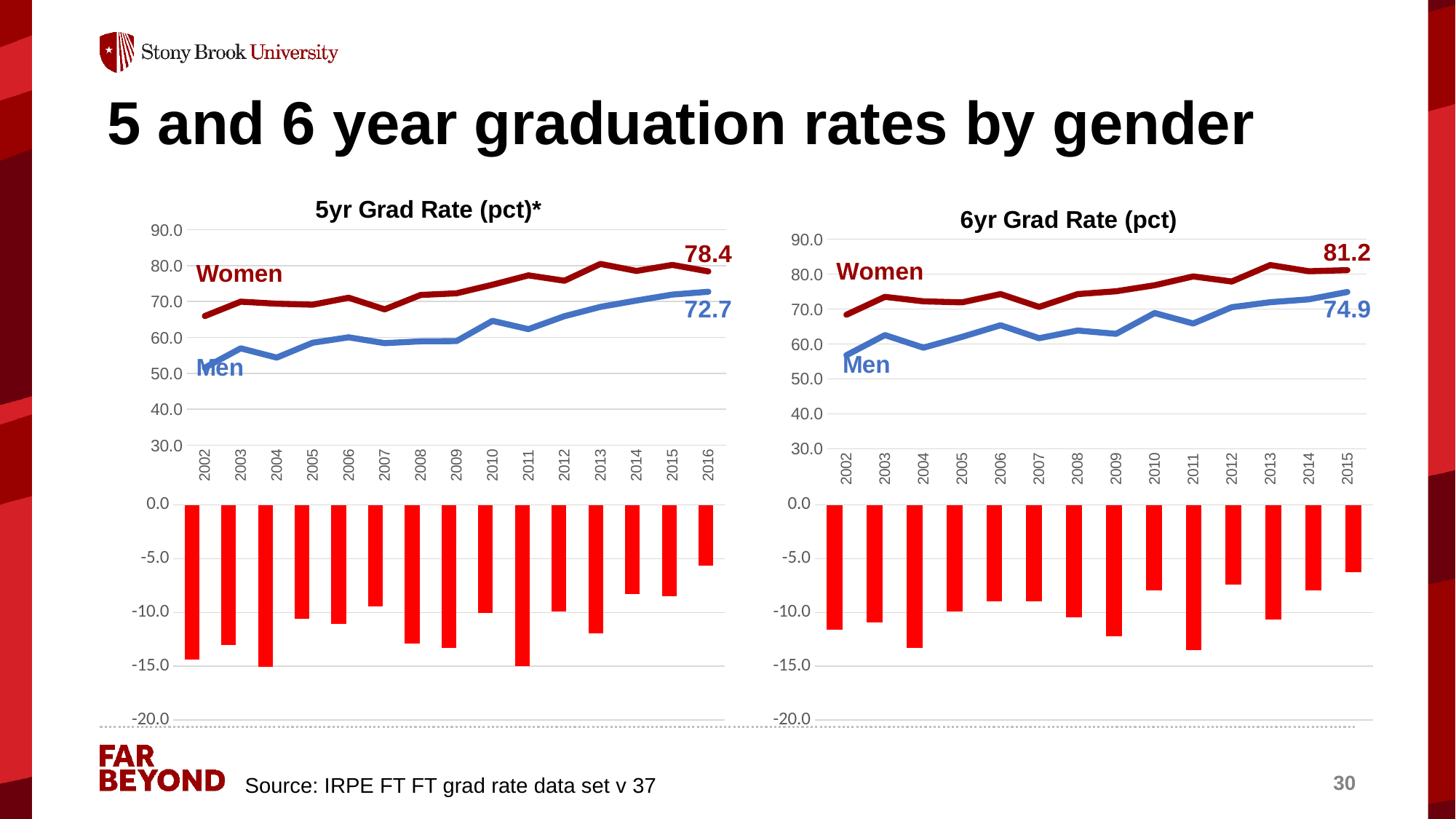
On the 6yr Grad Rate (pct) chart, what is the labeled value for Men in 2015? 74.9 On the 6yr Grad Rate (pct) chart, does the Men line generally rise or fall from 2002 to 2015? rise How many years are shown on the x axis of the 5yr Grad Rate (pct)* chart? 15 How many years are shown on the x axis of the 6yr Grad Rate (pct) chart? 14 On the 5yr Grad Rate (pct)* chart, is the Men value for 2002 greater or less than 60.0? less On the 5yr Grad Rate (pct)* chart, what is the labeled value for Men in 2016? 72.7 On the 5yr Grad Rate (pct)* chart, what is the difference between the labeled Women and Men values in 2016? 5.7 On the 6yr Grad Rate (pct) chart, what is the difference between the labeled Women and Men values in 2015? 6.3 What kind of chart is used to plot the Women and Men series on the 5yr Grad Rate (pct)* chart? line chart On the 5yr Grad Rate (pct)* chart, what is the labeled value for Women in 2016? 78.4 On the 6yr Grad Rate (pct) chart, which series has the higher value in 2015, Women or Men? Women On the 6yr Grad Rate (pct) chart, what is the labeled value for Women in 2015? 81.2